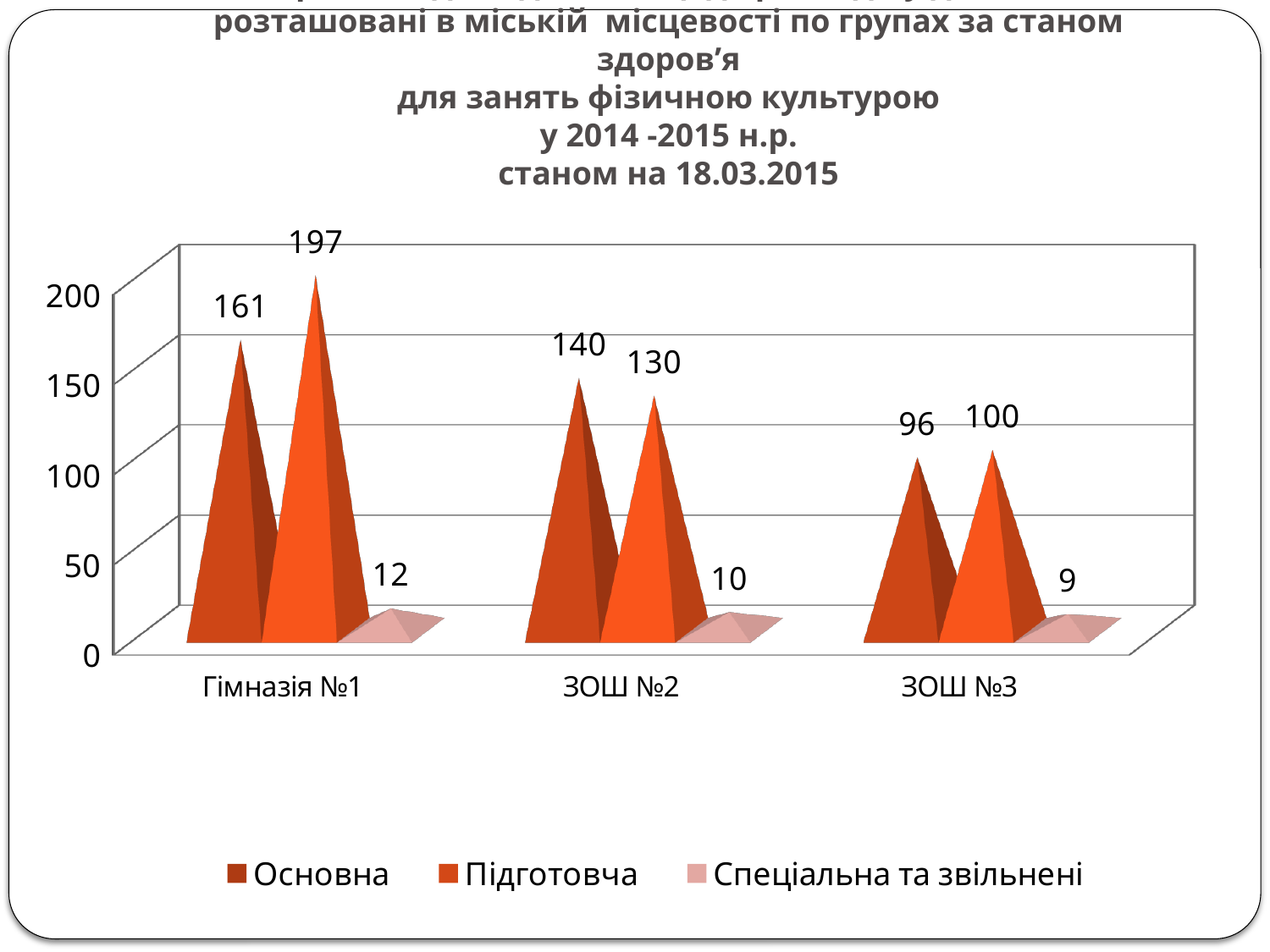
How many schools are shown on the x axis? 3 What is the total of the three values for ЗОШ №2? 280 Which is larger at ЗОШ №2: Основна or Підготовча? Основна What is the difference between the Підготовча and Основна values at Гімназія №1? 36 What kind of chart is shown on the slide? bar chart Which school has the highest value for Основна? Гімназія №1 What is the value for Основна at ЗОШ №2? 140 What is the value for Підготовча at Гімназія №1? 197 How many series does the legend list? 3 What is the value for Спеціальна та звільнені at ЗОШ №3? 9 Is the value for Основна at ЗОШ №3 greater or less than 100? less Which school has the lowest value for Підготовча? ЗОШ №3